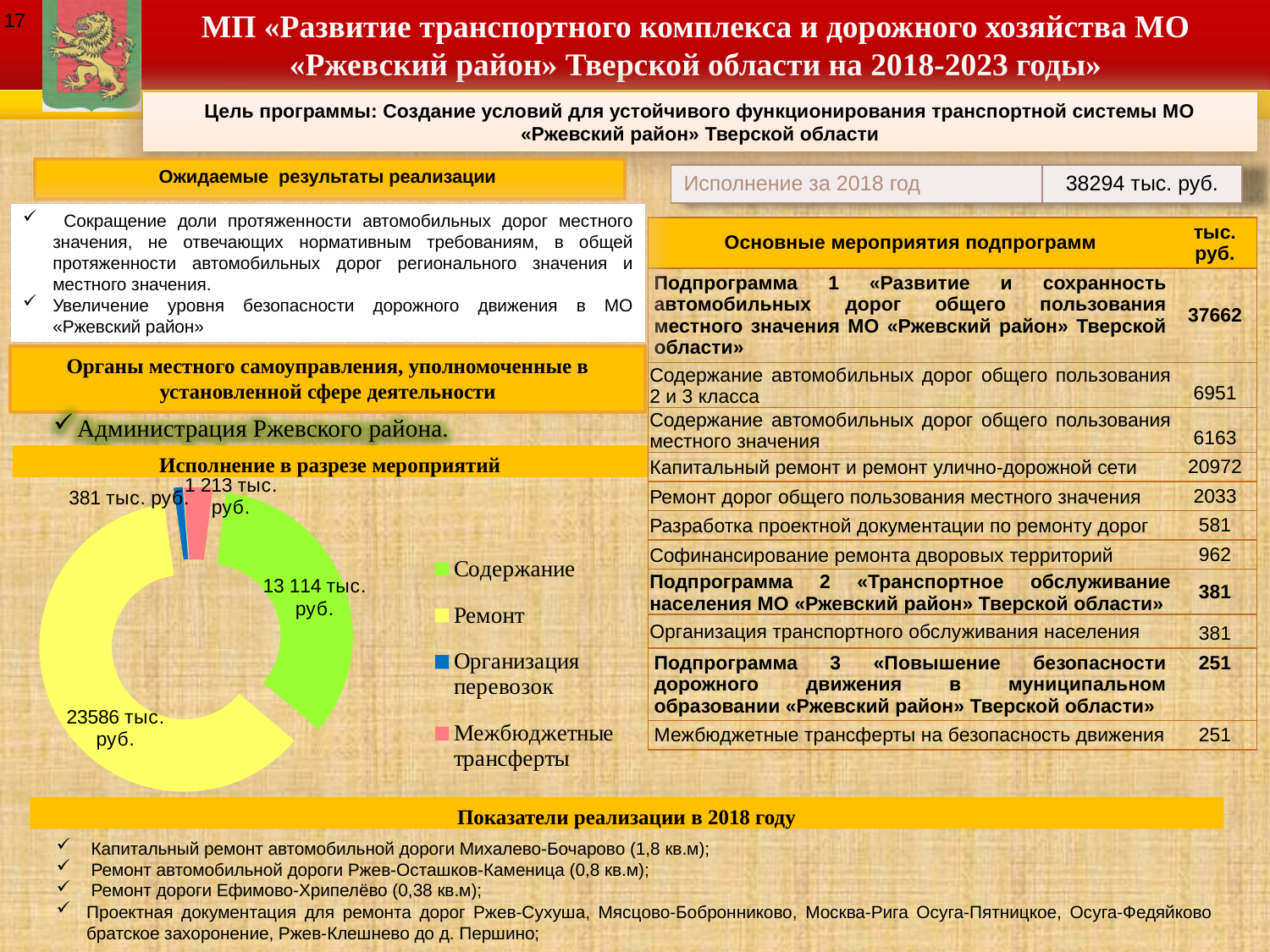
Which category has the smallest segment in the chart «Исполнение в разрезе мероприятий»? Организация перевозок Which category has the largest segment in the chart «Исполнение в разрезе мероприятий»? Ремонт In the chart «Исполнение в разрезе мероприятий», what is the value for Межбюджетные трансферты? 1 213 тыс. руб. In the chart «Исполнение в разрезе мероприятий», what colour is the Содержание segment? Green In the chart «Исполнение в разрезе мероприятий», what is the value for Ремонт? 23586 тыс. руб. In the chart «Исполнение в разрезе мероприятий», what is the value for Содержание? 13 114 тыс. руб. In the chart «Исполнение в разрезе мероприятий», which is larger: Межбюджетные трансферты or Организация перевозок? Межбюджетные трансферты In the chart «Исполнение в разрезе мероприятий», what is the value for Организация перевозок? 381 тыс. руб. How many categories does the legend of the chart «Исполнение в разрезе мероприятий» list? 4 In the chart «Исполнение в разрезе мероприятий», what colour is the Ремонт segment? Yellow What kind of chart is shown under the heading «Исполнение в разрезе мероприятий»? Doughnut (pie) chart In the chart «Исполнение в разрезе мероприятий», how much larger is Ремонт than Содержание? 10472 тыс. руб.